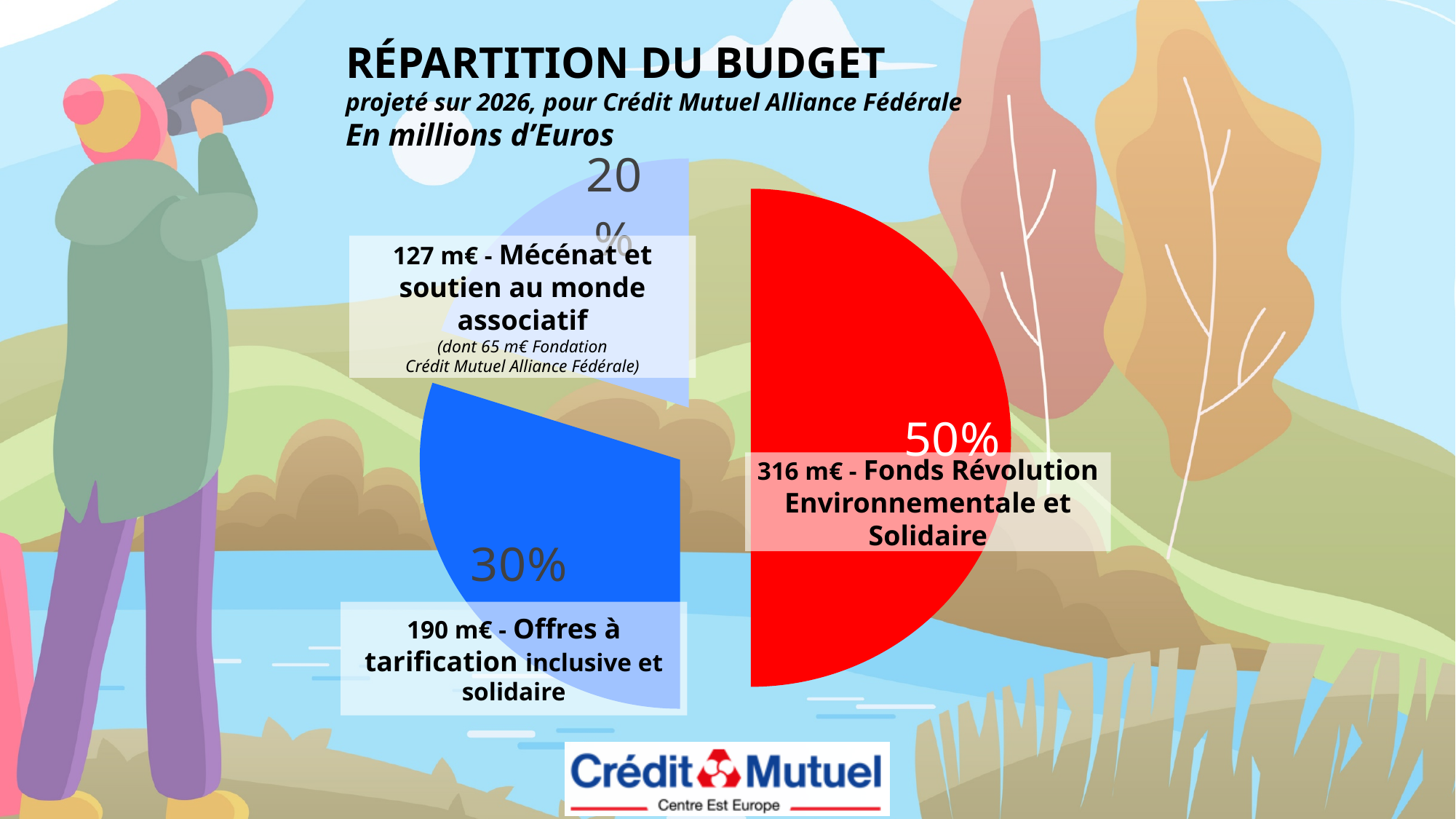
What is the amount in millions of euros for the Fonds Révolution Environnementale et Solidaire? 316 m€ What share of the budget goes to Offres à tarification inclusive et solidaire? 30% How many slices does the pie chart have? 3 What is the amount in millions of euros for Offres à tarification inclusive et solidaire? 190 m€ What share of the budget goes to the Fonds Révolution Environnementale et Solidaire? 50% Which category receives the smallest share of the budget? Mécénat et soutien au monde associatif Which category receives the largest share of the budget? Fonds Révolution Environnementale et Solidaire What is the title of the chart? RÉPARTITION DU BUDGET What is the difference in m€ between the Fonds Révolution Environnementale et Solidaire and Offres à tarification inclusive et solidaire? 126 m€ What share of the budget goes to Mécénat et soutien au monde associatif? 20% What is the amount in millions of euros for Mécénat et soutien au monde associatif? 127 m€ What kind of chart is shown on the slide? pie chart